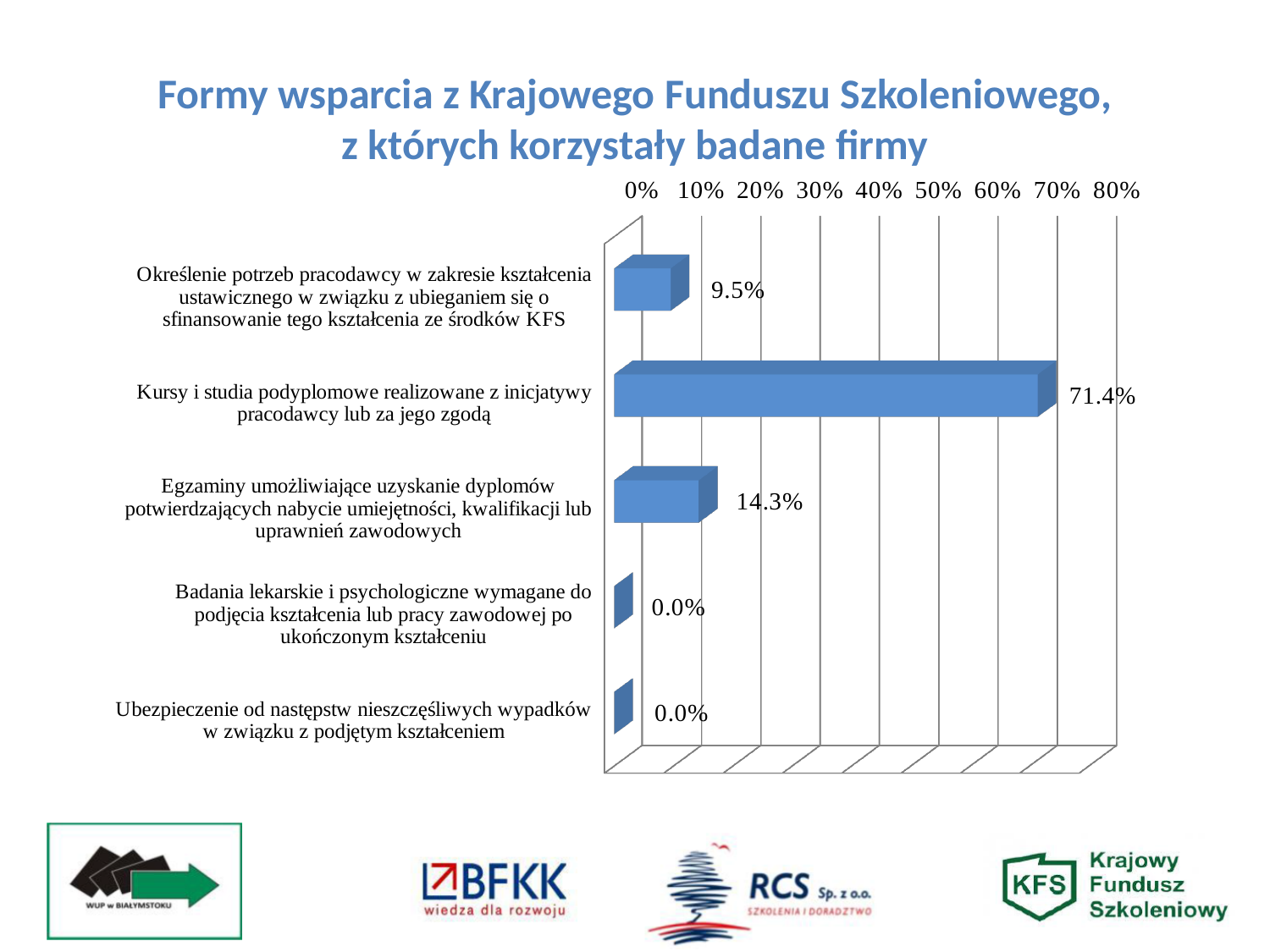
What is the value for "Kursy i studia podyplomowe realizowane z inicjatywy pracodawcy lub za jego zgodą"? 71.4% Which is larger: the value for "Egzaminy umożliwiające uzyskanie dyplomów" or for "Określenie potrzeb pracodawcy"? Egzaminy umożliwiające uzyskanie dyplomów How many categories have a value of 0.0%? 2 How many categories are shown in the chart? 5 What is the value for "Egzaminy umożliwiające uzyskanie dyplomów potwierdzających nabycie umiejętności, kwalifikacji lub uprawnień zawodowych"? 14.3% Is the value for "Kursy i studia podyplomowe" greater or less than 60%? greater What is the difference between the values for "Kursy i studia podyplomowe" and "Egzaminy umożliwiające uzyskanie dyplomów"? 57.1% What is the difference between the values for "Egzaminy umożliwiające uzyskanie dyplomów" and "Określenie potrzeb pracodawcy"? 4.8% What is the value for "Ubezpieczenie od następstw nieszczęśliwych wypadków w związku z podjętym kształceniem"? 0.0% What kind of chart is shown on the slide? bar chart Which category has the highest value? Kursy i studia podyplomowe realizowane z inicjatywy pracodawcy lub za jego zgodą What is the value for "Określenie potrzeb pracodawcy w zakresie kształcenia ustawicznego w związku z ubieganiem się o sfinansowanie tego kształcenia ze środków KFS"? 9.5%